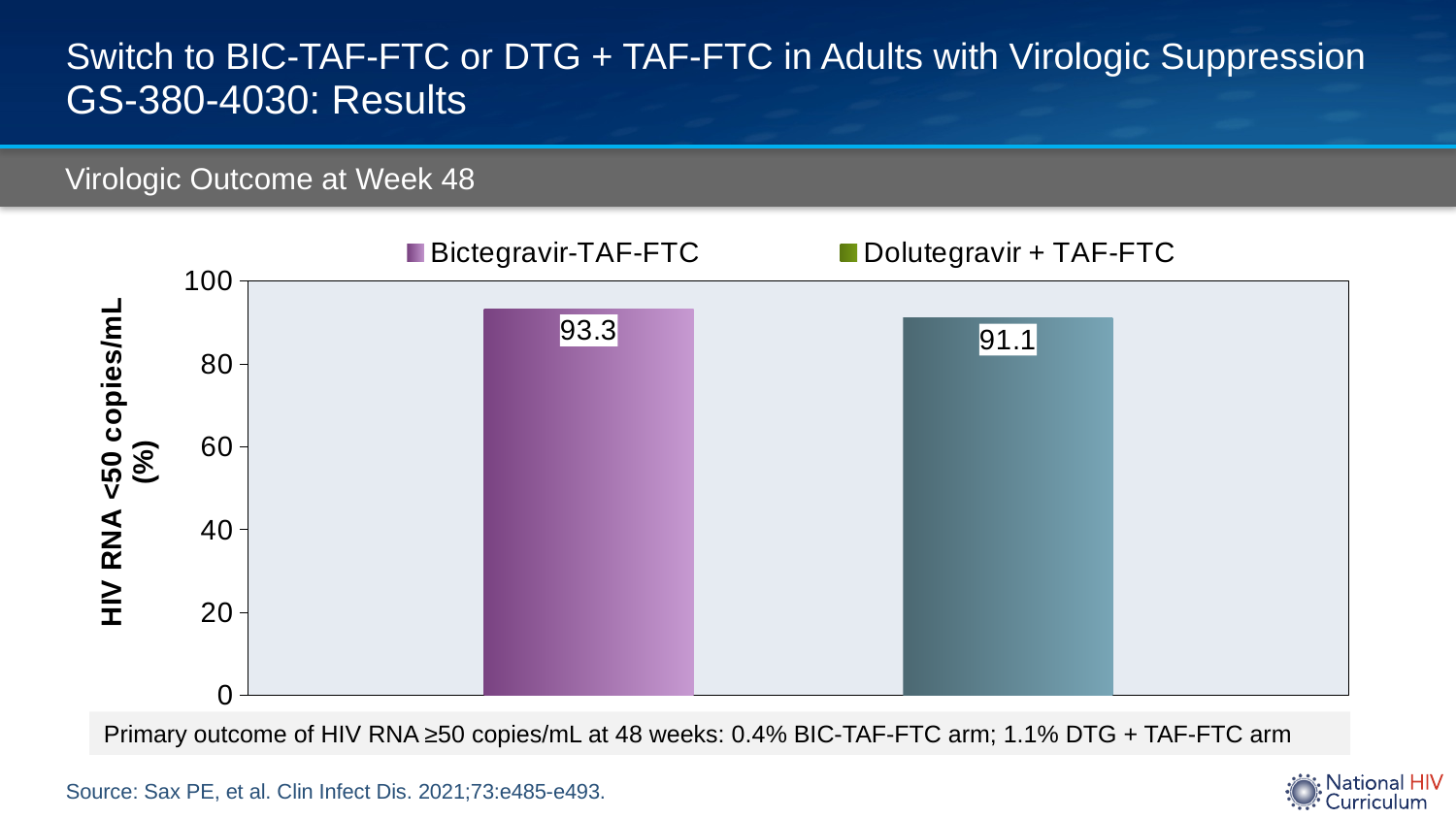
How many bars are plotted in the chart? 2 What is the value for Bictegravir-TAF-FTC? 93.3 What is the title of the chart? Virologic Outcome at Week 48 What is the difference between the Bictegravir-TAF-FTC and Dolutegravir + TAF-FTC values? 2.2 What kind of chart is shown? Bar chart What is the y-axis label of the chart? HIV RNA <50 copies/mL (%) What is the value for Dolutegravir + TAF-FTC? 91.1 Which series has the lower value? Dolutegravir + TAF-FTC Is the value for Dolutegravir + TAF-FTC greater or less than 80? greater How many series does the legend list? 2 Which series has the higher value? Bictegravir-TAF-FTC Is the value for Bictegravir-TAF-FTC greater or less than 100? less